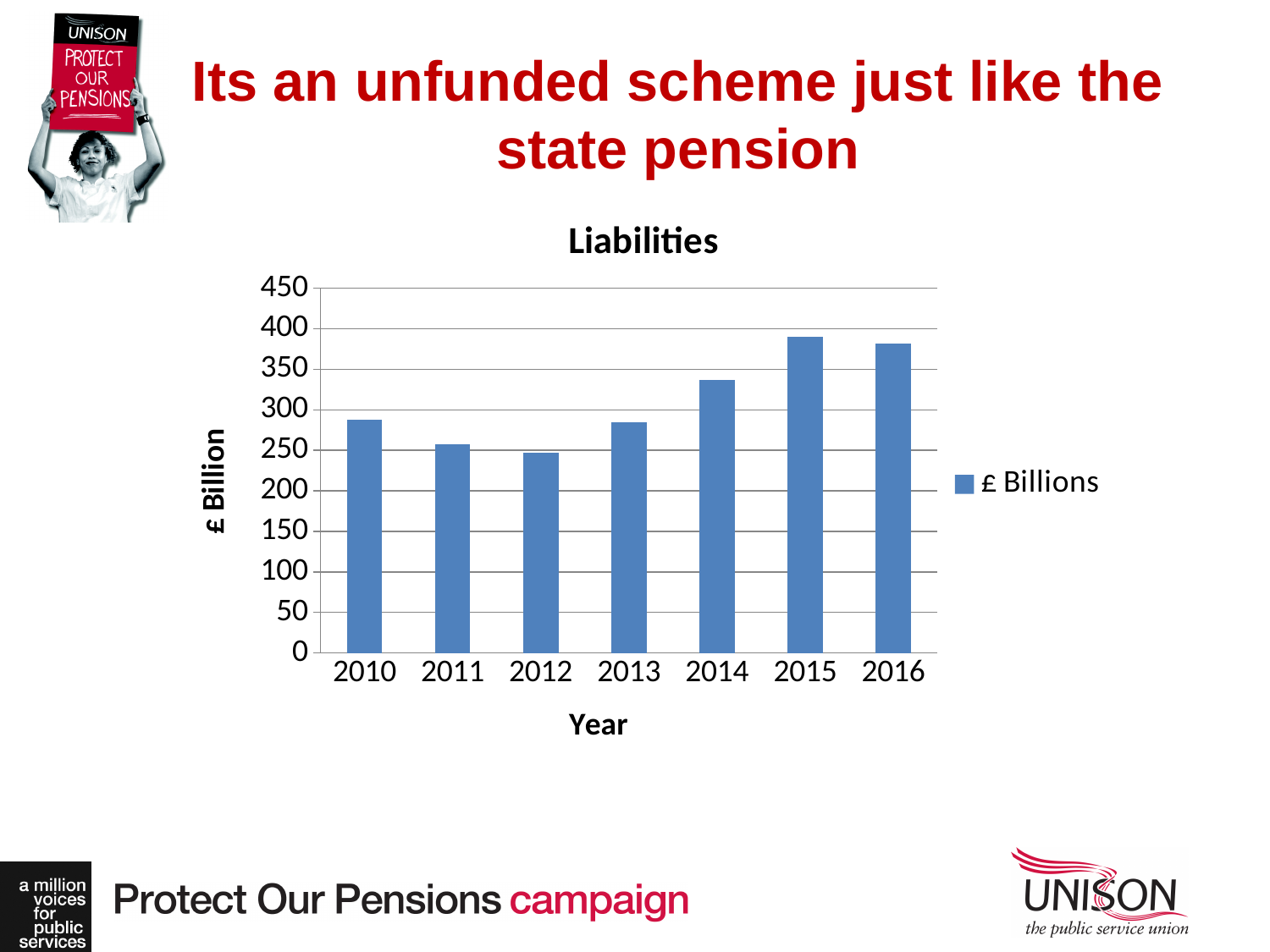
Which is larger, the value for 2014 or the value for 2013? 2014 How many years are shown on the x axis of the chart? 7 Which year has the highest liabilities? 2015 What is the title of the chart? Liabilities What is the label on the y axis of the chart? £ Billion Is the value for 2015 greater or less than 400? less Is the value for 2010 greater or less than 250? greater How many series does the legend list? 1 Which year has the lowest liabilities? 2012 Is the value for 2014 greater or less than 300? greater What type of chart is shown on the slide? bar chart